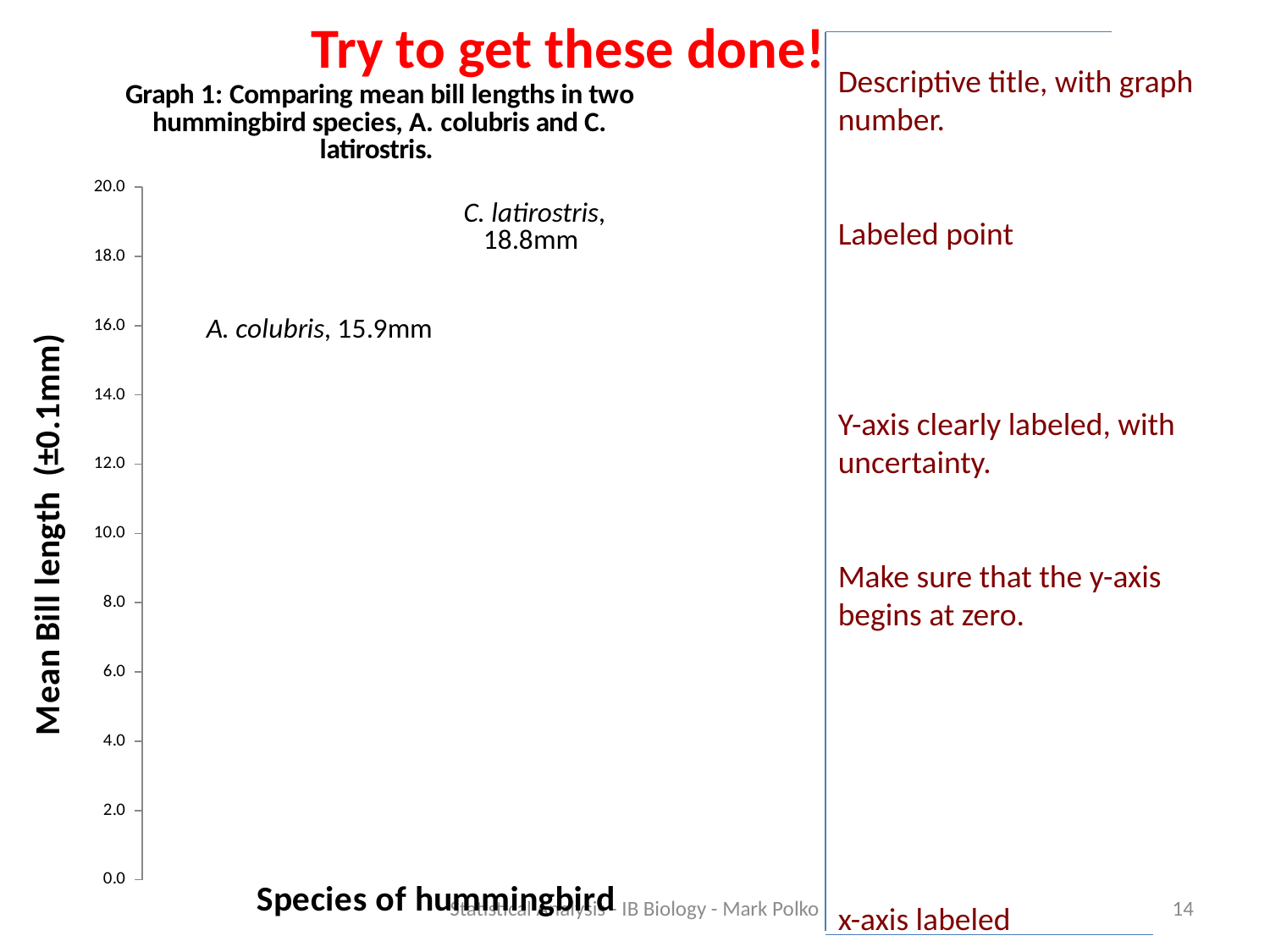
Which species has the higher mean bill length? C. latirostris What is the mean bill length shown for C. latirostris? 18.8mm Is the mean bill length of A. colubris greater or less than that of C. latirostris? less How many hummingbird species are plotted on the chart? 2 What is the mean bill length shown for A. colubris? 15.9mm What is the difference between the mean bill lengths of C. latirostris and A. colubris? 2.9mm What is the label on the x-axis of the chart? Species of hummingbird What is the highest value shown on the y-axis? 20.0 What is the label on the y-axis of the chart? Mean Bill length (±0.1mm) Which species has the lower mean bill length? A. colubris Is the value for C. latirostris greater or less than 18.0? greater Is the value for A. colubris greater or less than 16.0? less